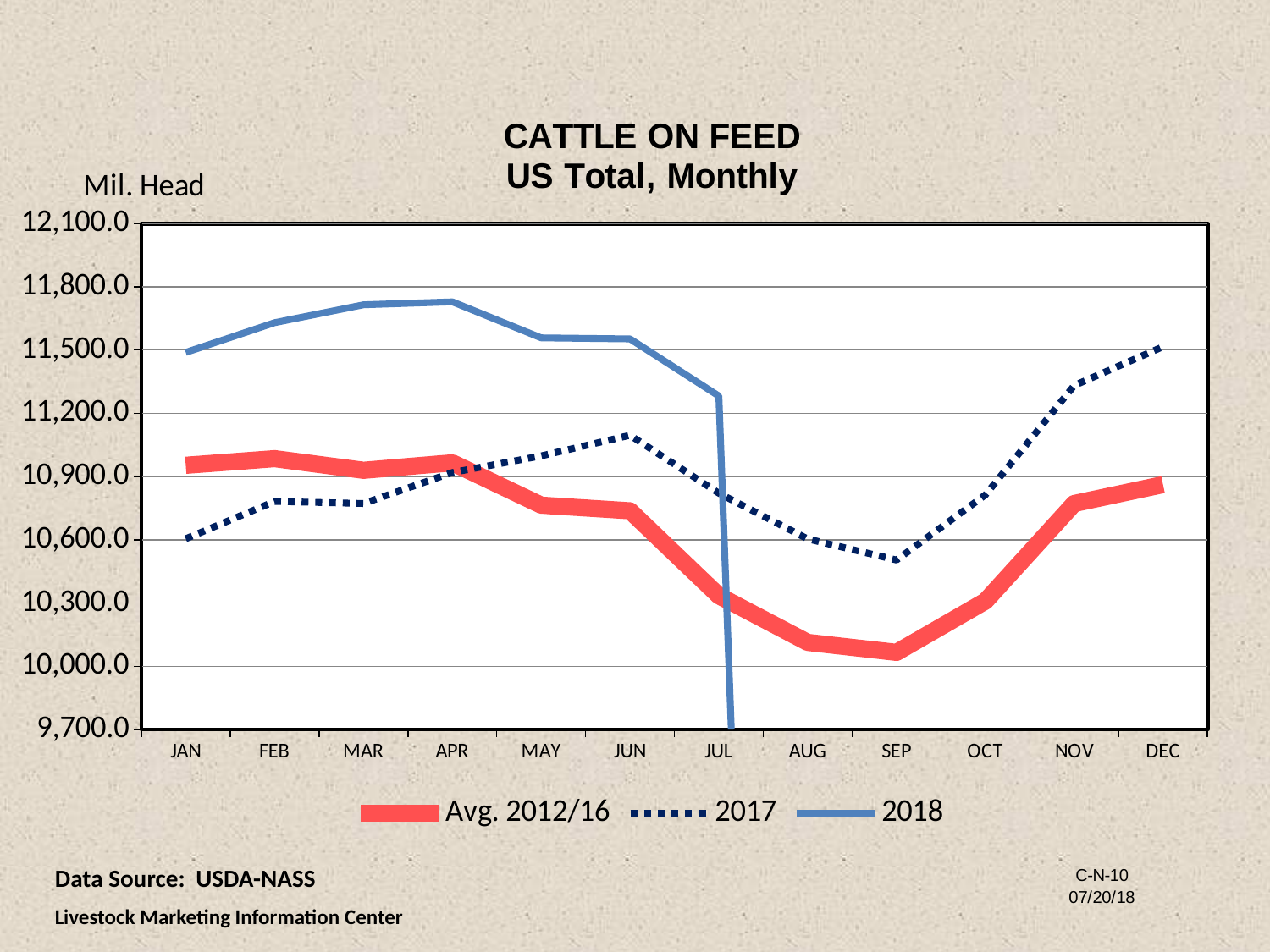
What unit label is shown above the y axis? Mil. Head In MAR, which series is higher: 2017 or 2018? 2018 Is the Avg. 2012/16 value for AUG greater or less than 10,300? less How many months are shown along the x axis? 12 Does the 2017 series rise or fall from SEP to DEC? Rise Is the 2017 value for DEC greater or less than 11,200? greater Is the 2017 value for SEP greater or less than 10,600? less In which month is the 2017 series at its highest? DEC How many series does the legend list? 3 What kind of chart is shown on the slide? Line chart In which month is the 2017 series at its lowest? SEP